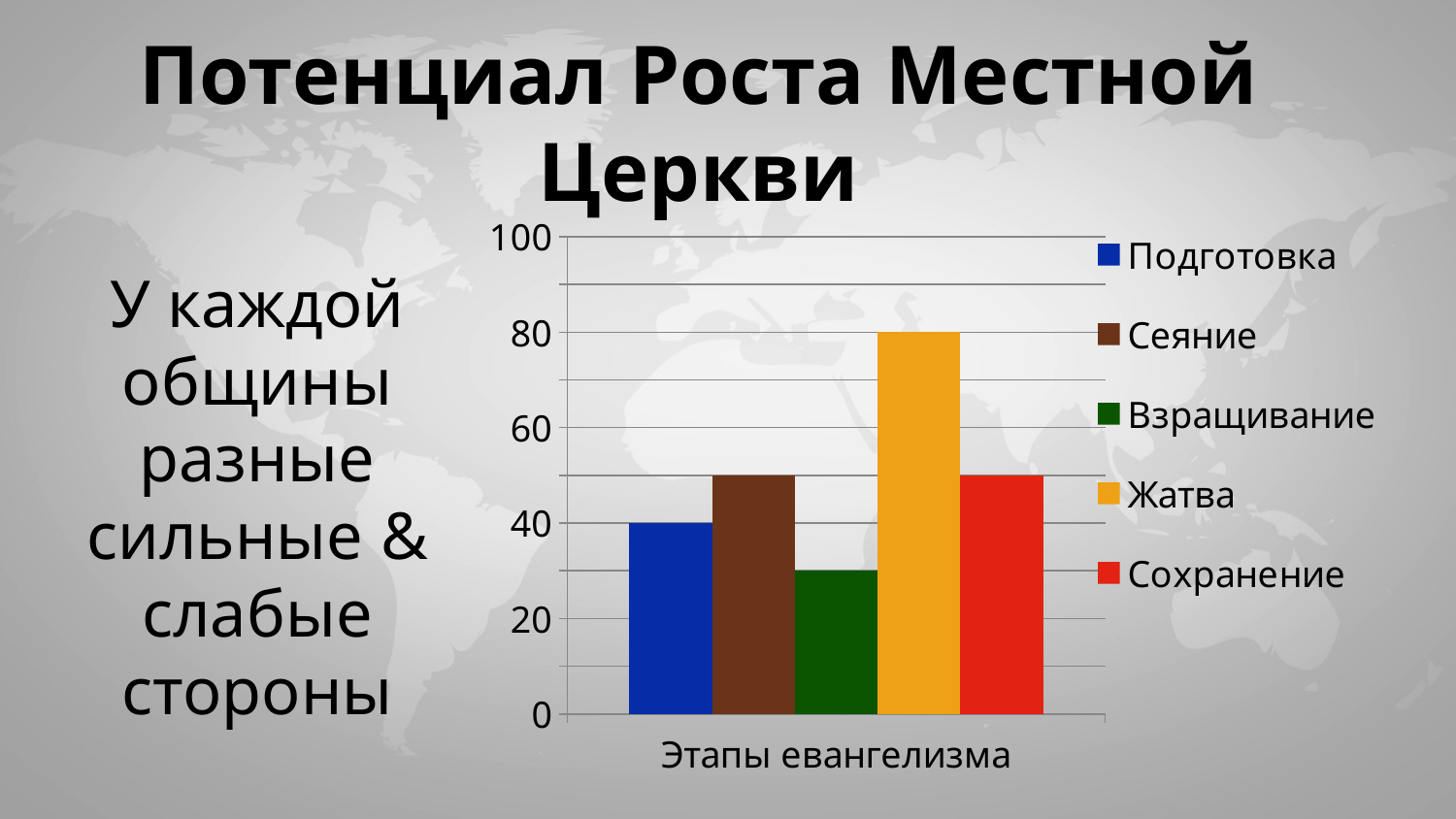
What is the label on the horizontal axis of the chart? Этапы евангелизма Which is larger, the Жатва bar or the Сохранение bar? Жатва What is the value of the Подготовка bar? 40 Is the value for Взращивание greater or less than 40? less How many series does the legend list? 5 Is the value for Сеяние greater or less than 40? greater What is the value of the Жатва bar? 80 Which series has the lowest bar? Взращивание What kind of chart is shown on the slide? Bar chart What is the difference between the Жатва bar and the Подготовка bar? 40 Which series has the highest bar? Жатва Is the value for Сохранение greater or less than 60? less